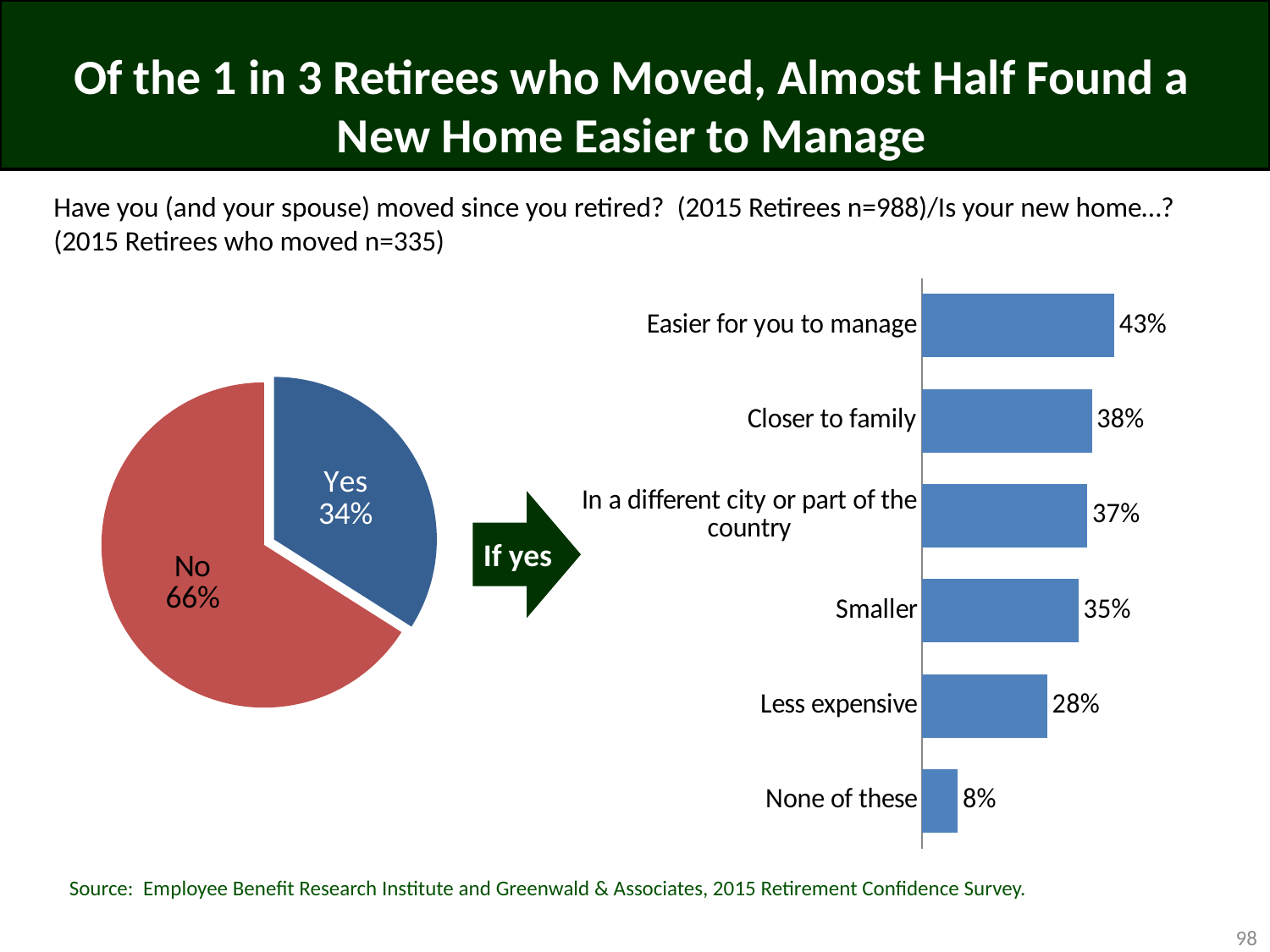
In the bar chart on the right, what is the difference between Closer to family and Smaller? 3% In the bar chart on the right, how many categories are shown? 6 In the pie chart on the left, what percentage of retirees answered Yes to having moved since retiring? 34% What type of chart is shown on the right side of the slide? Bar chart In the bar chart on the right, what percentage said their new home is easier for them to manage? 43% In the pie chart on the left, which slice is larger, Yes or No? No In the bar chart on the right, which is larger, Smaller or Less expensive? Smaller In the bar chart on the right, what percentage said their new home is less expensive? 28% In the pie chart on the left, how many slices are there? 2 In the bar chart on the right, which category has the highest value? Easier for you to manage In the pie chart on the left, what percentage of retirees answered No? 66% In the bar chart on the right, which category has the lowest value? None of these